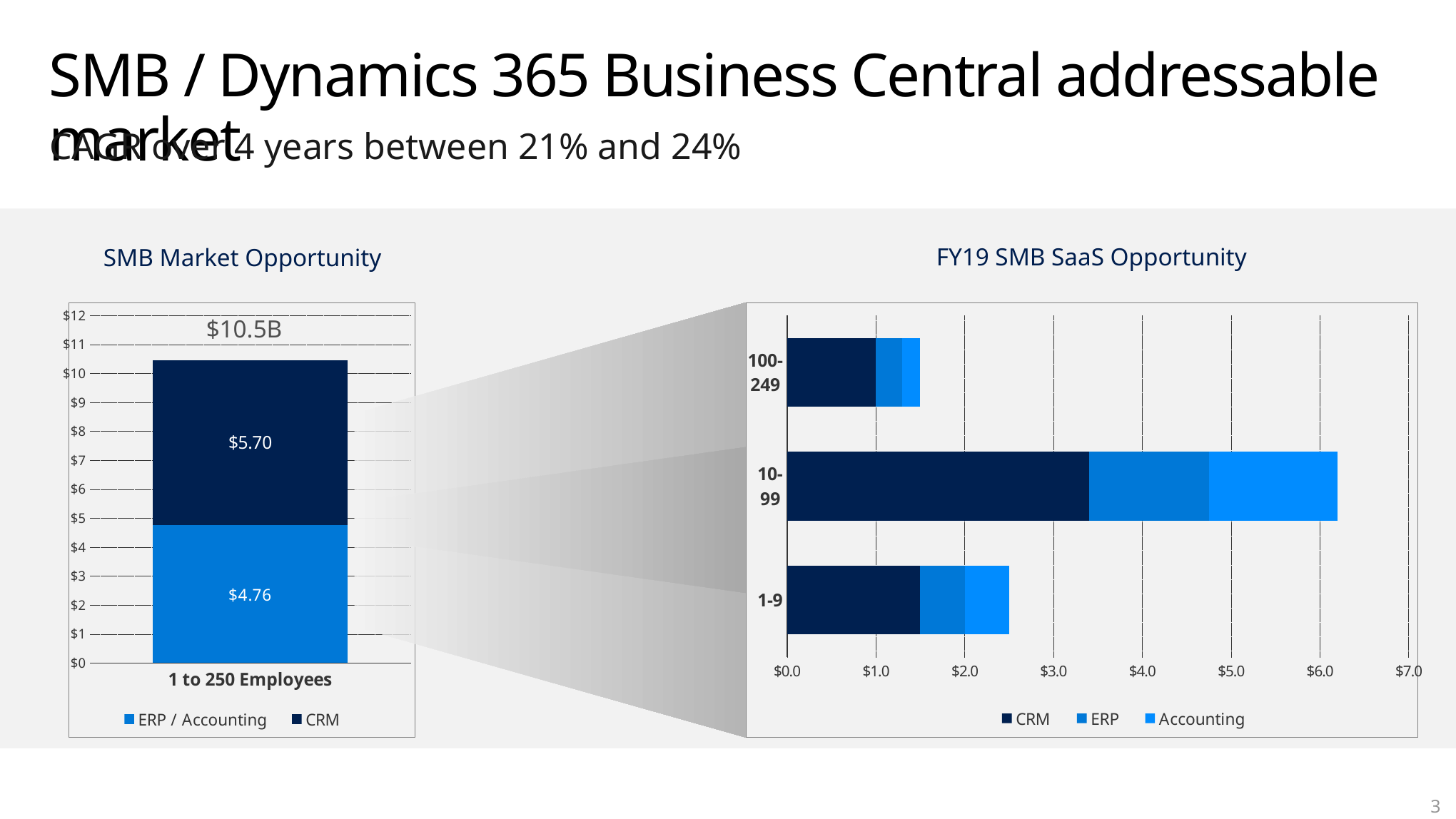
In the FY19 SMB SaaS Opportunity chart, which employee-size category has the longest total bar? 10-99 In the SMB Market Opportunity chart, which segment is larger, CRM or ERP / Accounting? CRM How many series does the legend of the SMB Market Opportunity chart list? 2 What kind of chart is the FY19 SMB SaaS Opportunity chart? Bar chart In the SMB Market Opportunity chart, what is the value of the CRM segment? $5.70 How many employee-size categories are shown in the FY19 SMB SaaS Opportunity chart? 3 In the SMB Market Opportunity chart, what is the value of the ERP / Accounting segment? $4.76 In the FY19 SMB SaaS Opportunity chart, is the total bar for 10-99 greater or less than $5.0? greater How many series does the legend of the FY19 SMB SaaS Opportunity chart list? 3 In the SMB Market Opportunity chart, what is the total shown above the stacked bar for 1 to 250 Employees? $10.5B In the SMB Market Opportunity chart, what is the difference between the CRM and ERP / Accounting values? $0.94 In the FY19 SMB SaaS Opportunity chart, is the total bar for 100-249 greater or less than $2.0? less